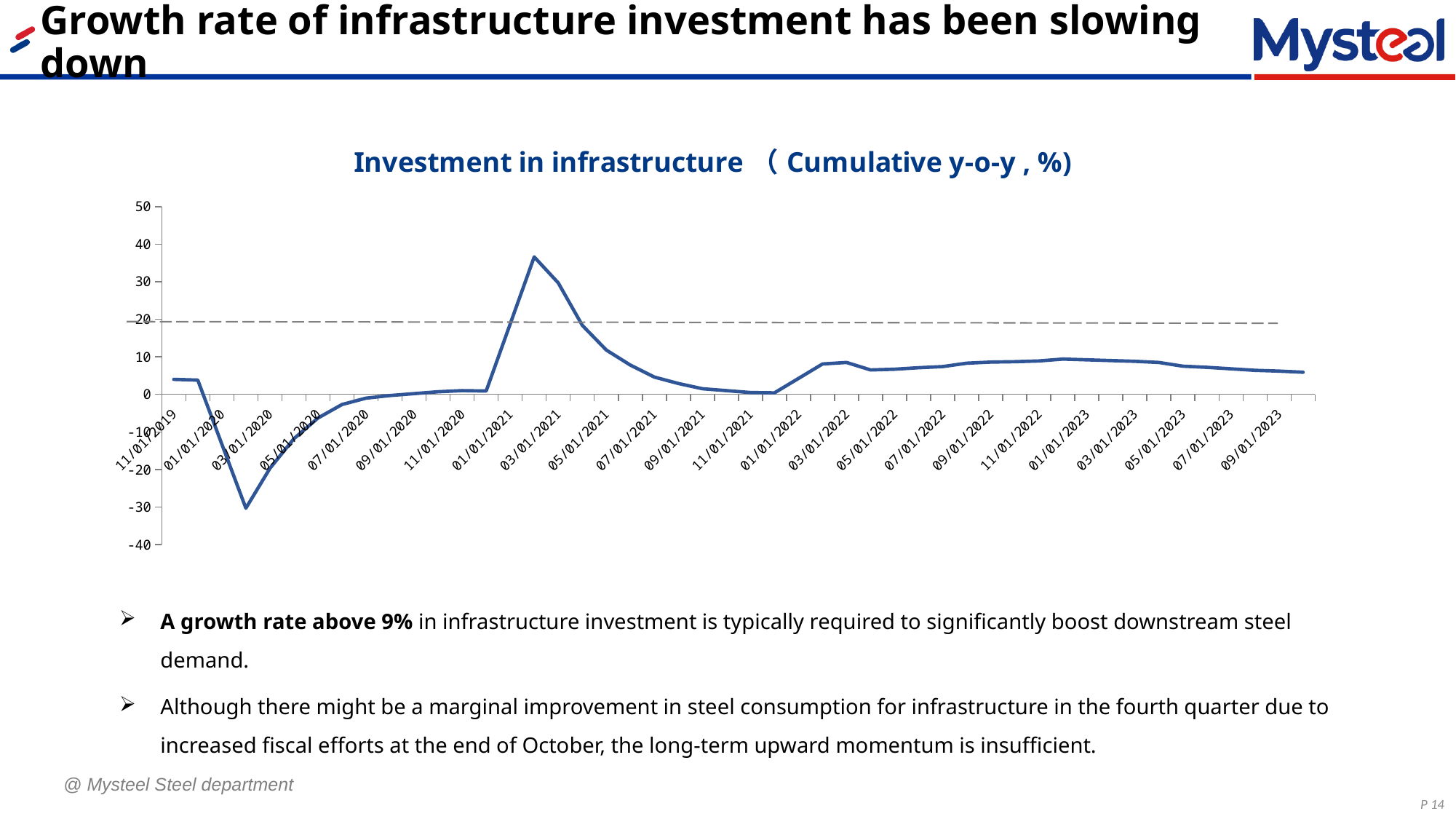
Around which x-axis date does the line reach its highest value? 03/01/2021 What is the title of the chart? Investment in infrastructure (Cumulative y-o-y, %) Around which x-axis date does the line reach its lowest value? 03/01/2020 Is the value at 03/01/2020 greater or less than -20? less Does the line rise or fall between 01/01/2023 and 09/01/2023? fall What is the highest value shown on the y axis? 50 Is the value at 03/01/2021 greater or less than 30? greater Which is larger, the value at 03/01/2021 or the value at 03/01/2022? 03/01/2021 Is the value at 11/01/2019 greater or less than 0? greater What kind of chart is shown on the slide? line chart Which is larger, the value at 05/01/2020 or the value at 05/01/2022? 05/01/2022